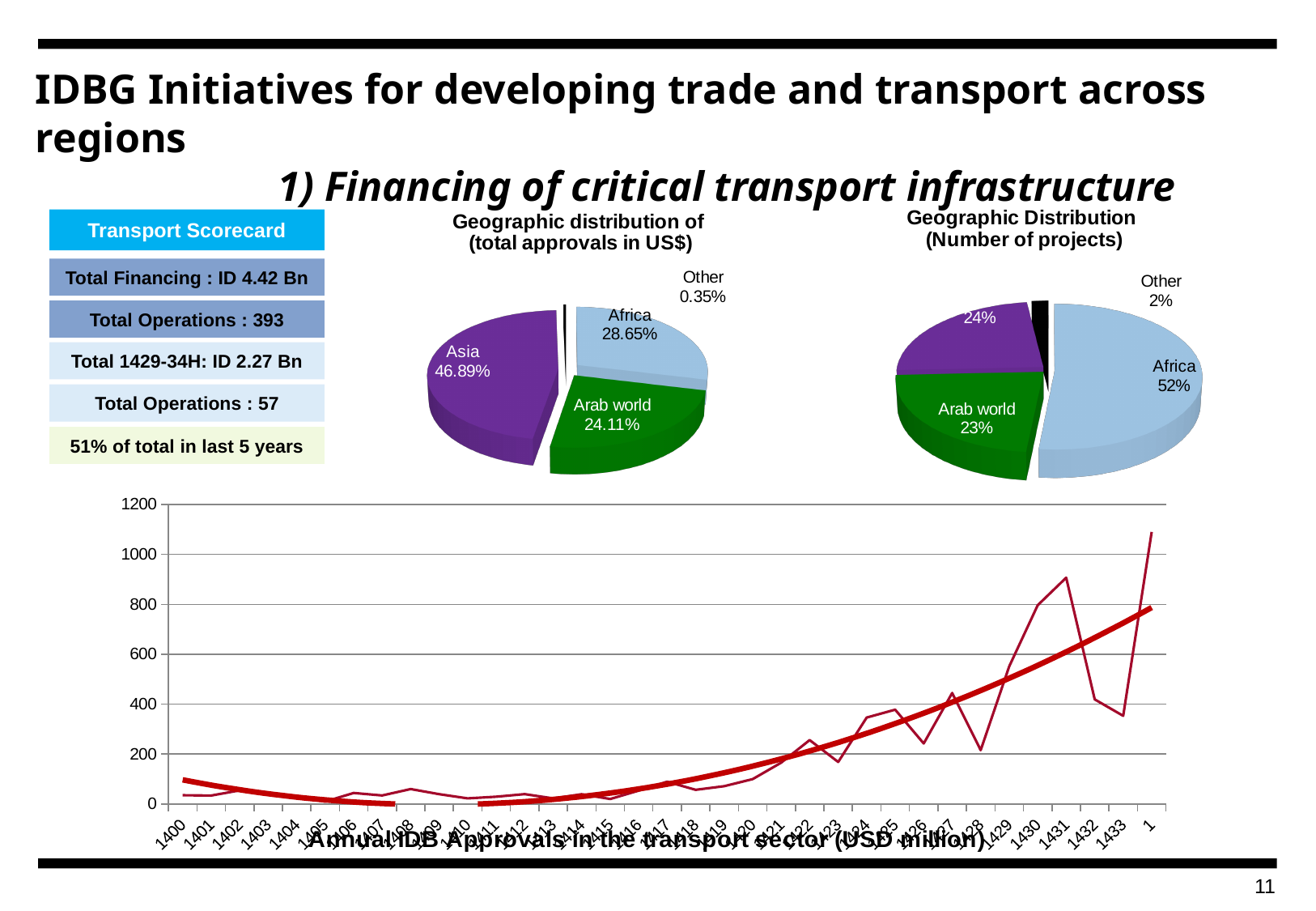
In the 'Geographic distribution of (total approvals in US$)' pie chart, which region has the largest share? Asia In the 'Geographic Distribution (Number of projects)' pie chart, is the Africa share larger or smaller than the Arab world share? larger In the 'Geographic Distribution (Number of projects)' pie chart, what share does the Arab world have? 23% What kind of chart is the 'Annual IDB Approvals in the transport sector (USD million)' chart at the bottom of the slide? line chart In the 'Geographic distribution of (total approvals in US$)' pie chart, what share does Asia have? 46.89% In the 'Geographic distribution of (total approvals in US$)' pie chart, what is the difference between the Africa and Arab world shares? 4.54% In the 'Geographic Distribution (Number of projects)' pie chart, which region has the largest share? Africa In the 'Geographic distribution of (total approvals in US$)' pie chart, what share does Africa have? 28.65% In the 'Annual IDB Approvals in the transport sector (USD million)' line chart, is the value for 1431 greater or less than 800? greater In the 'Geographic distribution of (total approvals in US$)' pie chart, which category has the smallest share? Other In the 'Annual IDB Approvals in the transport sector (USD million)' line chart, do the values generally rise or fall from 1400 to the end of the x axis? rise In the 'Geographic Distribution (Number of projects)' pie chart, what share does Africa have? 52%